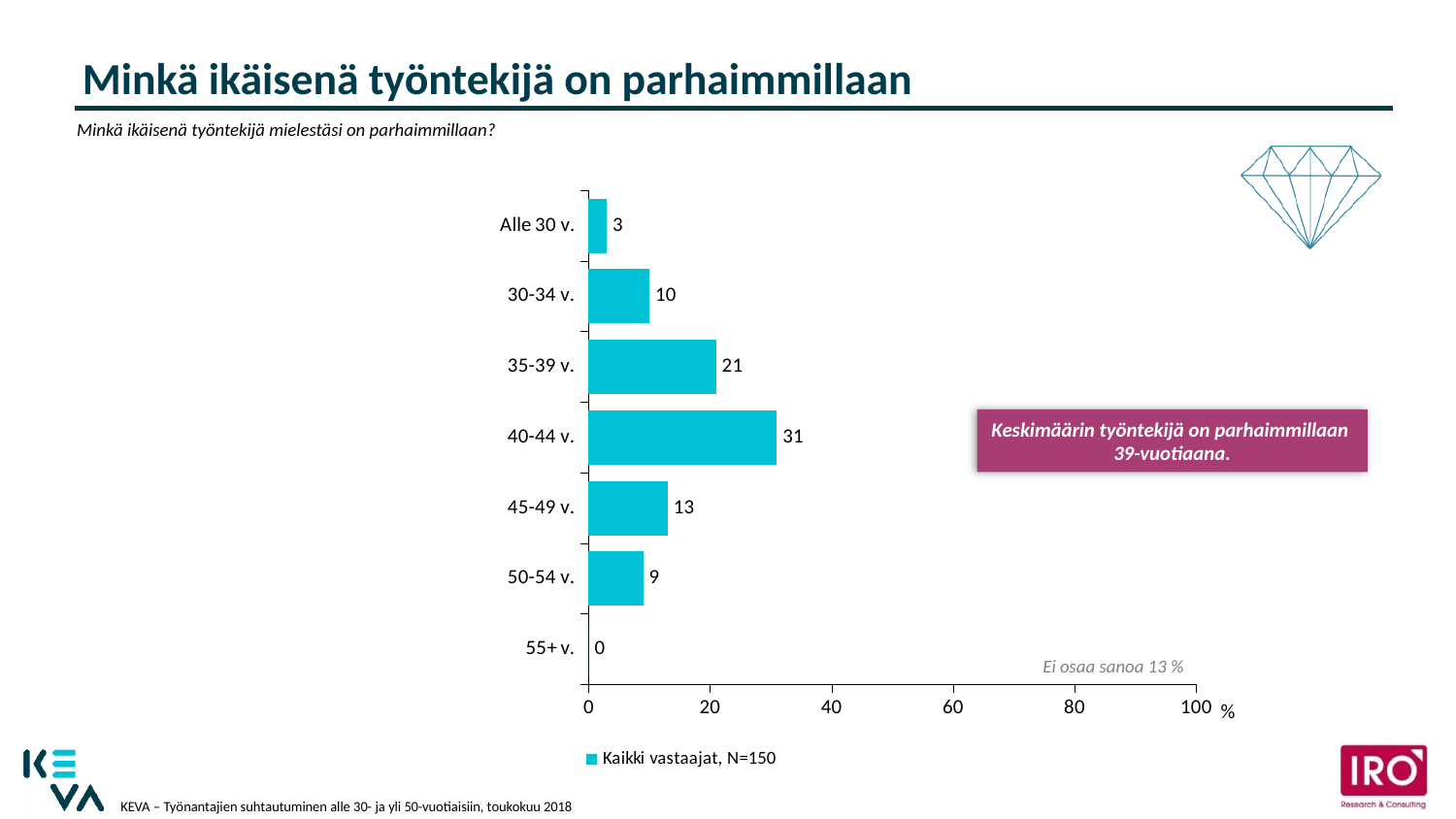
Which age category has the lowest value? 55+ v. How many series does the legend list? 1 Which is larger, the value for 45-49 v. or the value for 50-54 v.? 45-49 v. What is the legend entry for the series shown? Kaikki vastaajat, N=150 What kind of chart is shown on the slide? bar chart How many age categories are shown on the chart? 7 What is the value for the 30-34 v. category? 10 What is the value for the 40-44 v. category? 31 Is the value for 35-39 v. greater or less than 20? greater What is the value for the 55+ v. category? 0 Which age category has the highest value? 40-44 v. What is the difference between the values for 40-44 v. and 35-39 v.? 10